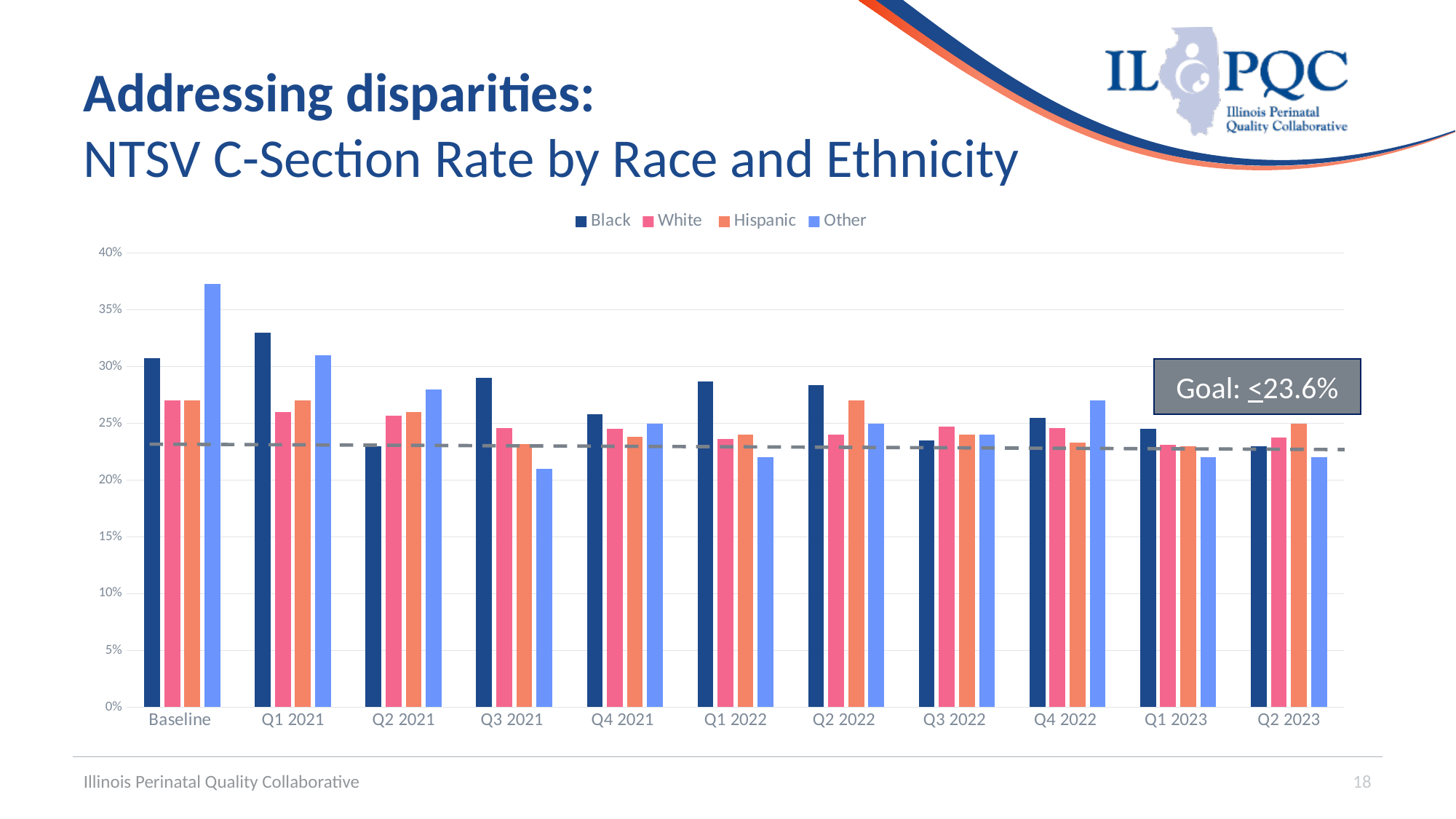
In Q3 2021, which is larger: the value for Black or the value for Other? Black Is the Baseline value for Other greater or less than 35%? greater How many time-period categories are shown on the x axis? 11 Is the Q2 2021 value for Black greater or less than 25%? less Does the Black series overall rise or fall from Baseline to Q2 2023? fall Which group has the highest NTSV C-section rate at Baseline? Other Which group has the lowest rate in Q3 2021? Other Is the Q2 2023 value for Other greater or less than 25%? less How many series does the legend list? 4 What kind of chart is shown on the slide? Bar chart What goal is stated in the box on the chart? ≤23.6%